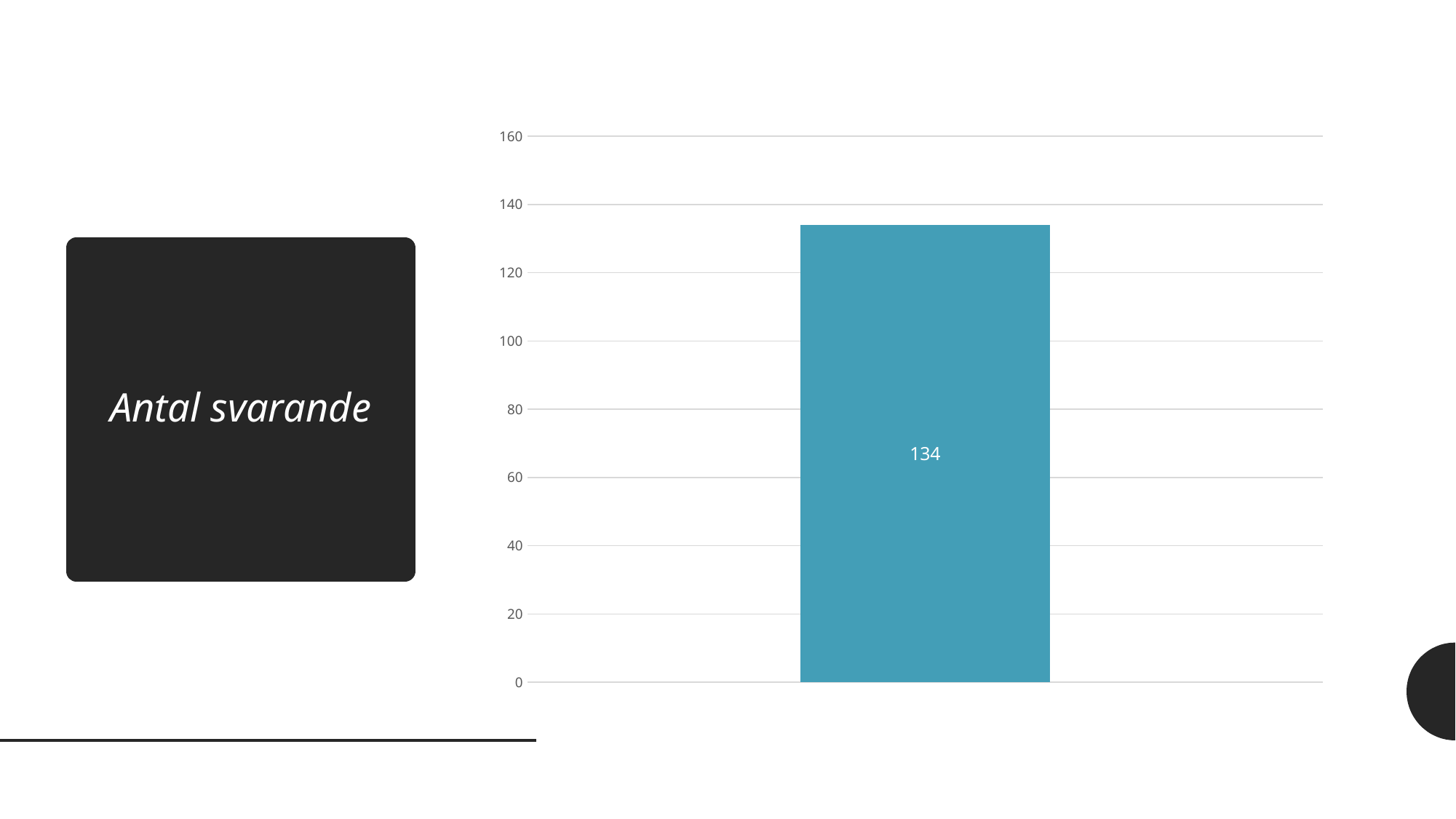
What is the text in the dark box to the left of the chart? Antal svarande Is the value of the bar greater or less than 140? less How many bars does the chart show? 1 What value is shown on the single bar in the chart? 134 What kind of chart is shown on the slide? bar chart Is the value of the bar greater or less than 120? greater What is the highest value shown on the vertical axis? 160